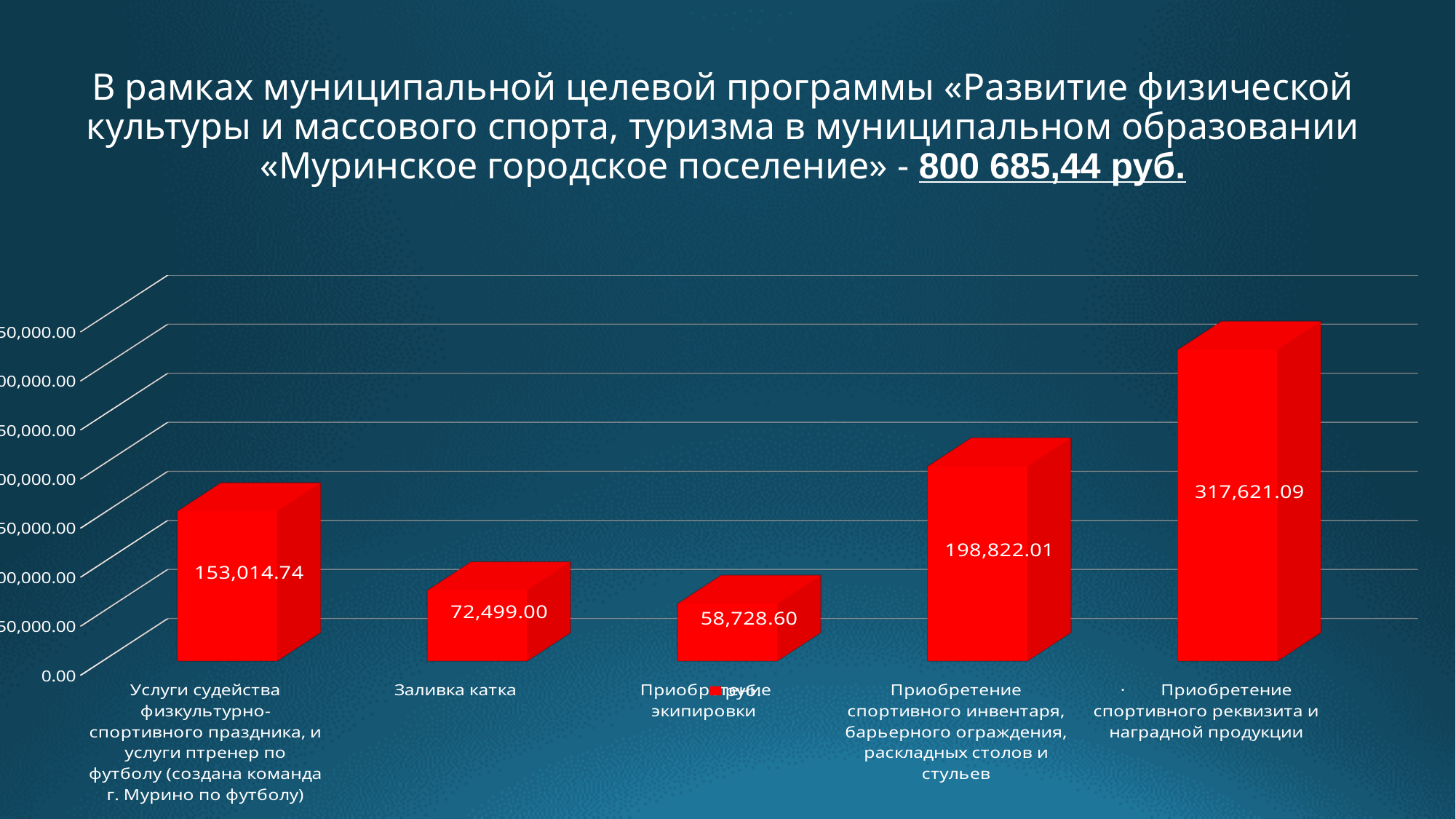
Which is larger: the value for «Заливка катка» or the value for «Приобретение экипировки»? Заливка катка What is the value for «Приобретение спортивного инвентаря, барьерного ограждения, раскладных столов и стульев»? 198,822.01 What kind of chart is shown on the slide? Bar chart What is the difference between the values for «Приобретение спортивного реквизита и наградной продукции» and «Приобретение спортивного инвентаря, барьерного ограждения, раскладных столов и стульев»? 118,799.08 What is the difference between the values for «Услуги судейства физкультурно-спортивного праздника...» and «Заливка катка»? 80,515.74 Which category has the lowest value? Приобретение экипировки Which category has the highest value? Приобретение спортивного реквизита и наградной продукции What is the value for «Услуги судейства физкультурно-спортивного праздника, и услуги птренер по футболу»? 153,014.74 What is the value for «Приобретение спортивного реквизита и наградной продукции»? 317,621.09 What is the value for «Заливка катка»? 72,499.00 How many categories are shown in the chart? 5 What is the legend entry shown for the series in the chart? руб.